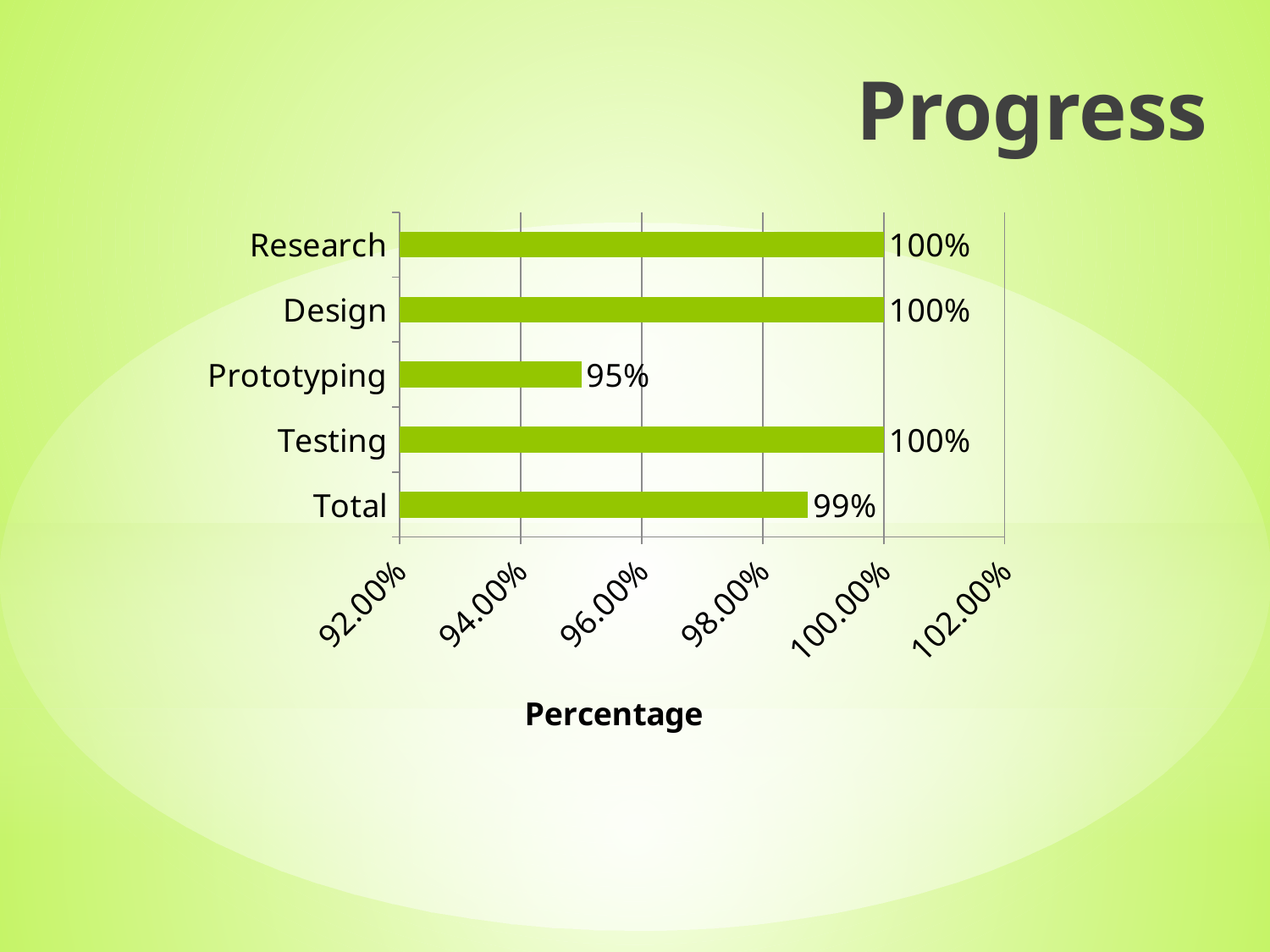
What is the value for Total? 99% What is the value for Testing? 100% What is the value for Research? 100% What is the label of the horizontal axis? Percentage What kind of chart is shown on the slide? bar chart What is the difference between the values for Design and Total? 1% Is the value for Prototyping greater or less than 96.00%? less What is the value for Prototyping? 95% Which category has the lowest value? Prototyping What is the difference between the values for Total and Prototyping? 4% Which is larger, the value for Design or the value for Prototyping? Design How many categories are shown in the chart? 5